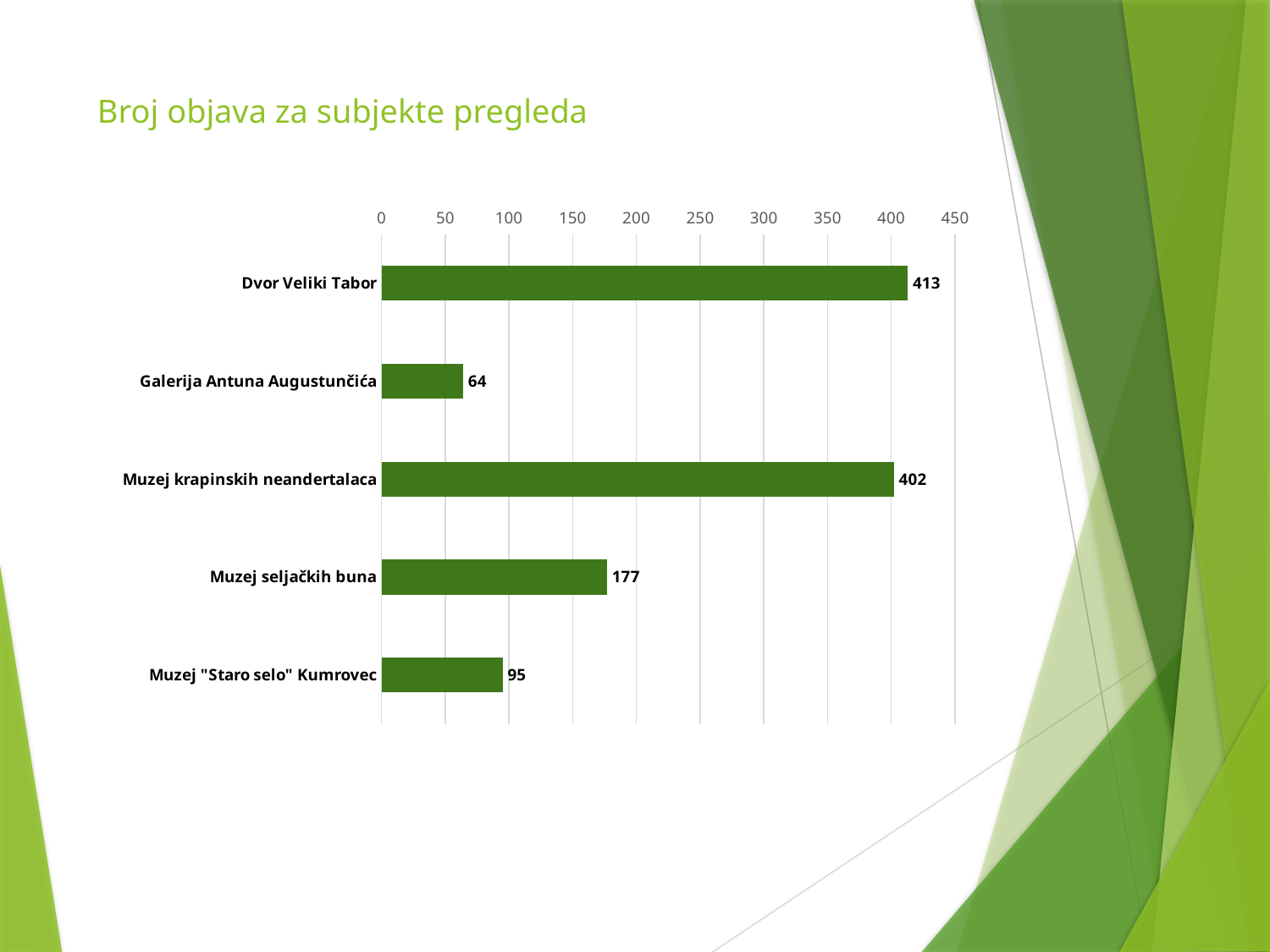
How many categories are shown in the chart? 5 What is the title of the slide? Broj objava za subjekte pregleda What is the value for Muzej seljačkih buna? 177 What is the value for Muzej "Staro selo" Kumrovec? 95 Which is larger, the value for Muzej seljačkih buna or the value for Muzej "Staro selo" Kumrovec? Muzej seljačkih buna What kind of chart is shown on the slide? Bar chart Which category has the lowest value? Galerija Antuna Augustunčića Which category has the highest value? Dvor Veliki Tabor What is the value for Galerija Antuna Augustunčića? 64 What is the value for Muzej krapinskih neandertalaca? 402 What is the difference between the values for Dvor Veliki Tabor and Muzej krapinskih neandertalaca? 11 What is the value for Dvor Veliki Tabor? 413